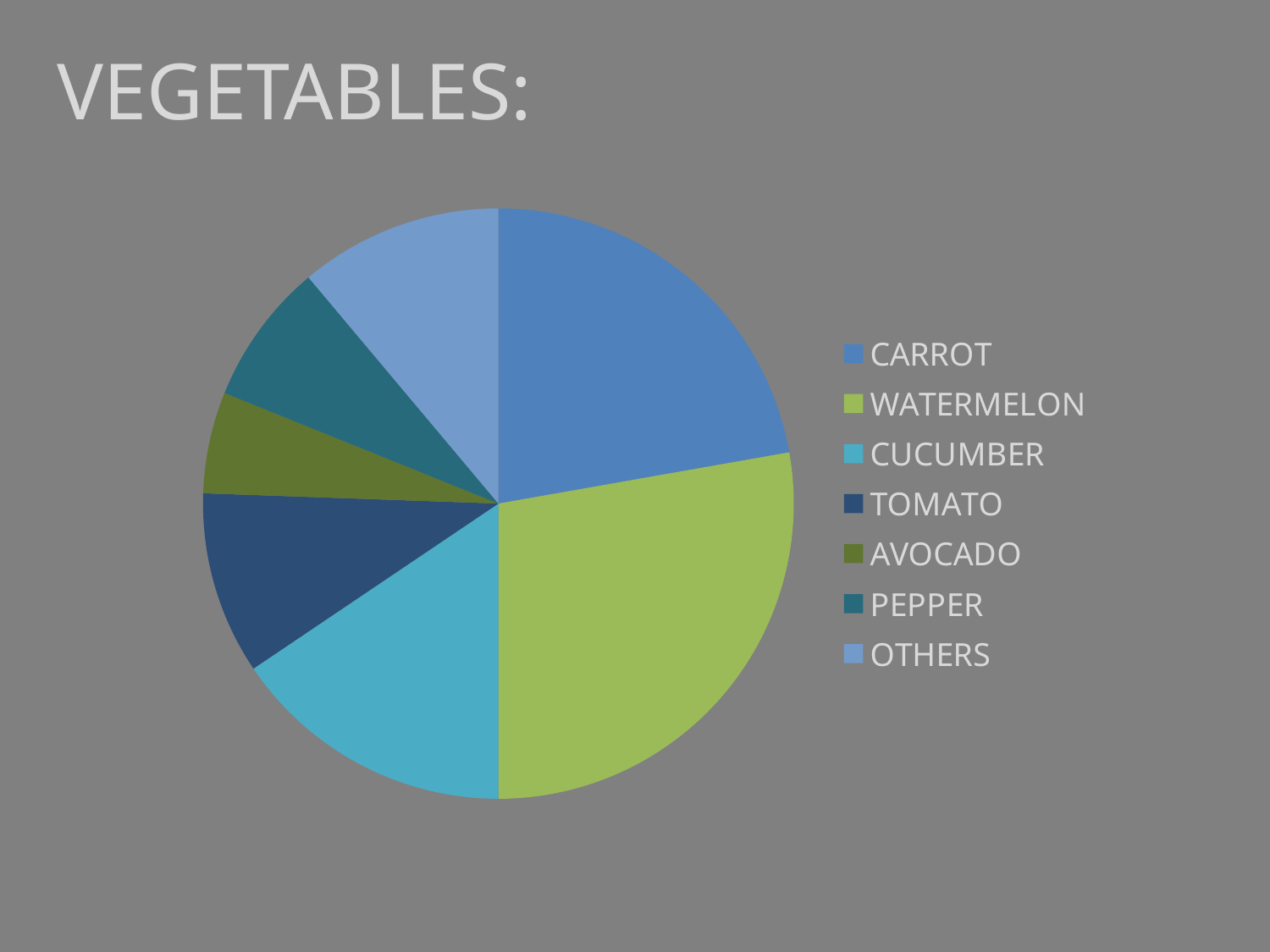
How many categories does the pie chart show? 7 Which slice is larger, CARROT or CUCUMBER? CARROT Which category is listed first in the legend? CARROT What kind of chart is shown on the slide? pie chart Which slice is larger, WATERMELON or OTHERS? WATERMELON Which slice is larger, CUCUMBER or AVOCADO? CUCUMBER Which category has the smallest slice of the pie? AVOCADO How many entries does the legend list? 7 Which category has the largest slice of the pie? WATERMELON What is the title of the slide containing the pie chart? VEGETABLES: